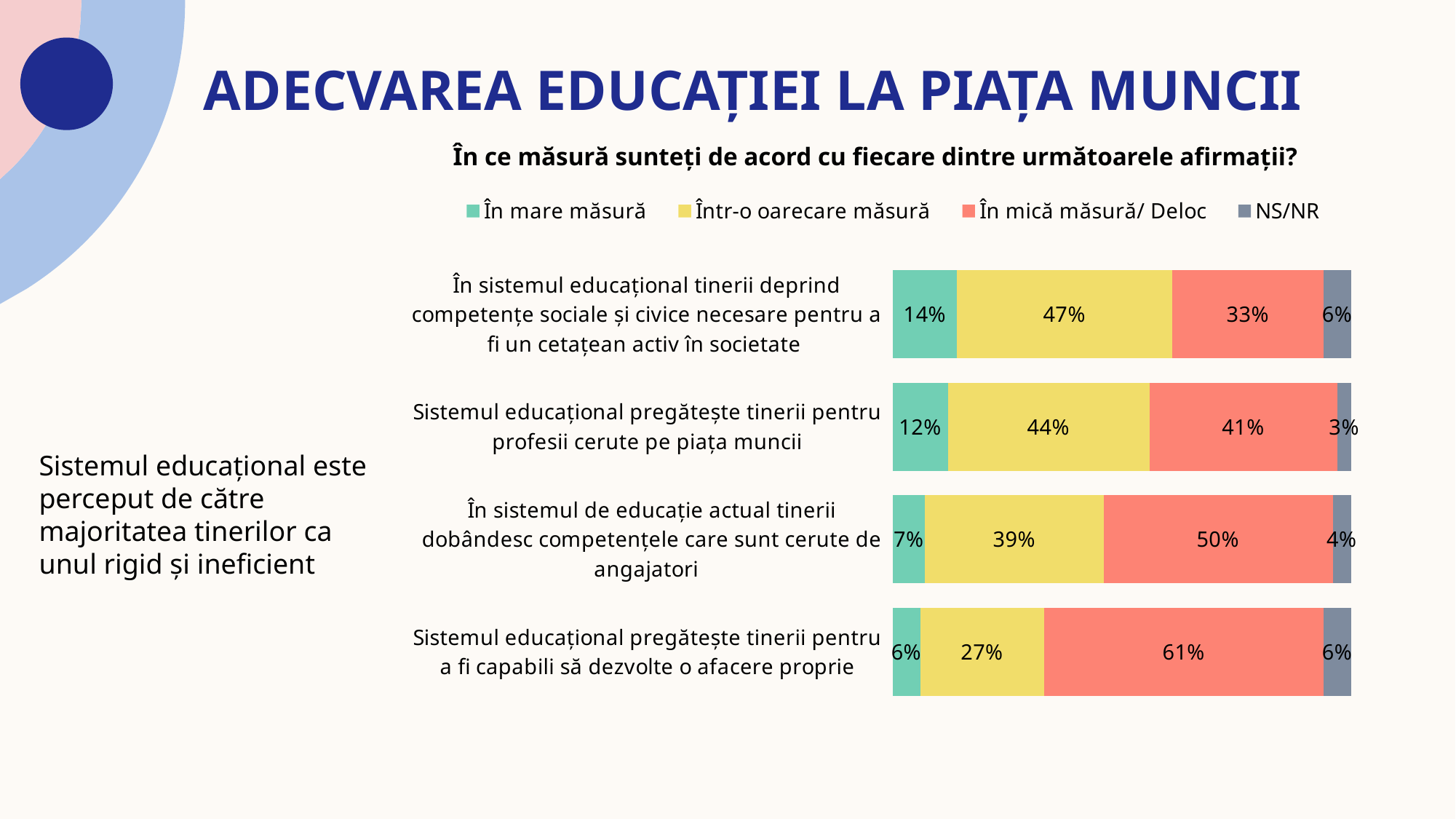
Which statement has the lowest "Într-o oarecare măsură" value? Sistemul educațional pregătește tinerii pentru a fi capabili să dezvolte o afacere proprie What colour represents the "NS/NR" series in the chart? grey Which is larger for the statement "Sistemul educațional pregătește tinerii pentru profesii cerute pe piața muncii": "Într-o oarecare măsură" or "În mică măsură/ Deloc"? Într-o oarecare măsură What kind of chart is shown on the slide? stacked bar chart What is the value of "Într-o oarecare măsură" for the statement "În sistemul de educație actual tinerii dobândesc competențele care sunt cerute de angajatori"? 39% What is the value of "În mare măsură" for the statement "Sistemul educațional pregătește tinerii pentru profesii cerute pe piața muncii"? 12% Which statement has the highest "În mare măsură" value? În sistemul educațional tinerii deprind competențe sociale și civice necesare pentru a fi un cetațean activ în societate How many series does the legend list? 4 What is the NS/NR value for the statement "În sistemul educațional tinerii deprind competențe sociale și civice necesare pentru a fi un cetațean activ în societate"? 6% How many statements (categories) are plotted in the chart? 4 What is the value of "În mică măsură/ Deloc" for the statement "Sistemul educațional pregătește tinerii pentru a fi capabili să dezvolte o afacere proprie"? 61% What is the difference between the "În mică măsură/ Deloc" values for "Sistemul educațional pregătește tinerii pentru a fi capabili să dezvolte o afacere proprie" and "În sistemul educațional tinerii deprind competențe sociale și civice necesare pentru a fi un cetațean activ în societate"? 28%